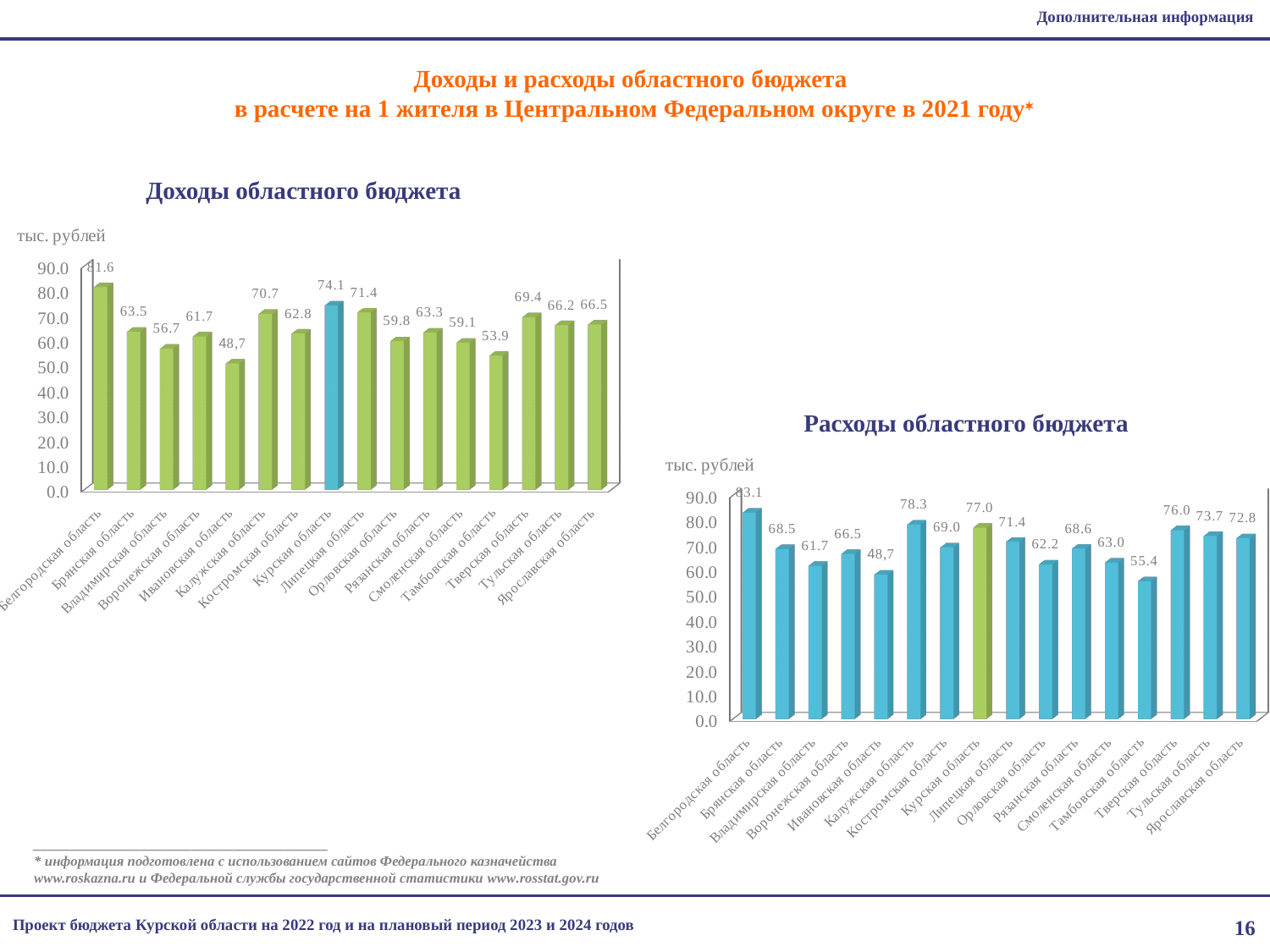
On the 'Доходы областного бюджета' chart, which region has the lowest value? Ивановская область On the 'Доходы областного бюджета' chart, which region has the highest value? Белгородская область On the 'Расходы областного бюджета' chart, which is larger: Калужская область or Курская область? Калужская область On the 'Расходы областного бюджета' chart, what is the value for Курская область? 77.0 On the 'Доходы областного бюджета' chart, how many regions are shown? 16 On the 'Доходы областного бюджета' chart, what is the difference between Белгородская область and Курская область? 7.5 What type of chart is the 'Расходы областного бюджета' chart? Bar chart On the 'Расходы областного бюджета' chart, what is the difference between Белгородская область and Тверская область? 7.1 On the 'Доходы областного бюджета' chart, what is the value for Курская область? 74.1 On the 'Доходы областного бюджета' chart, what unit is shown above the vertical axis? тыс. рублей On the 'Расходы областного бюджета' chart, what is the value for Тамбовская область? 55.4